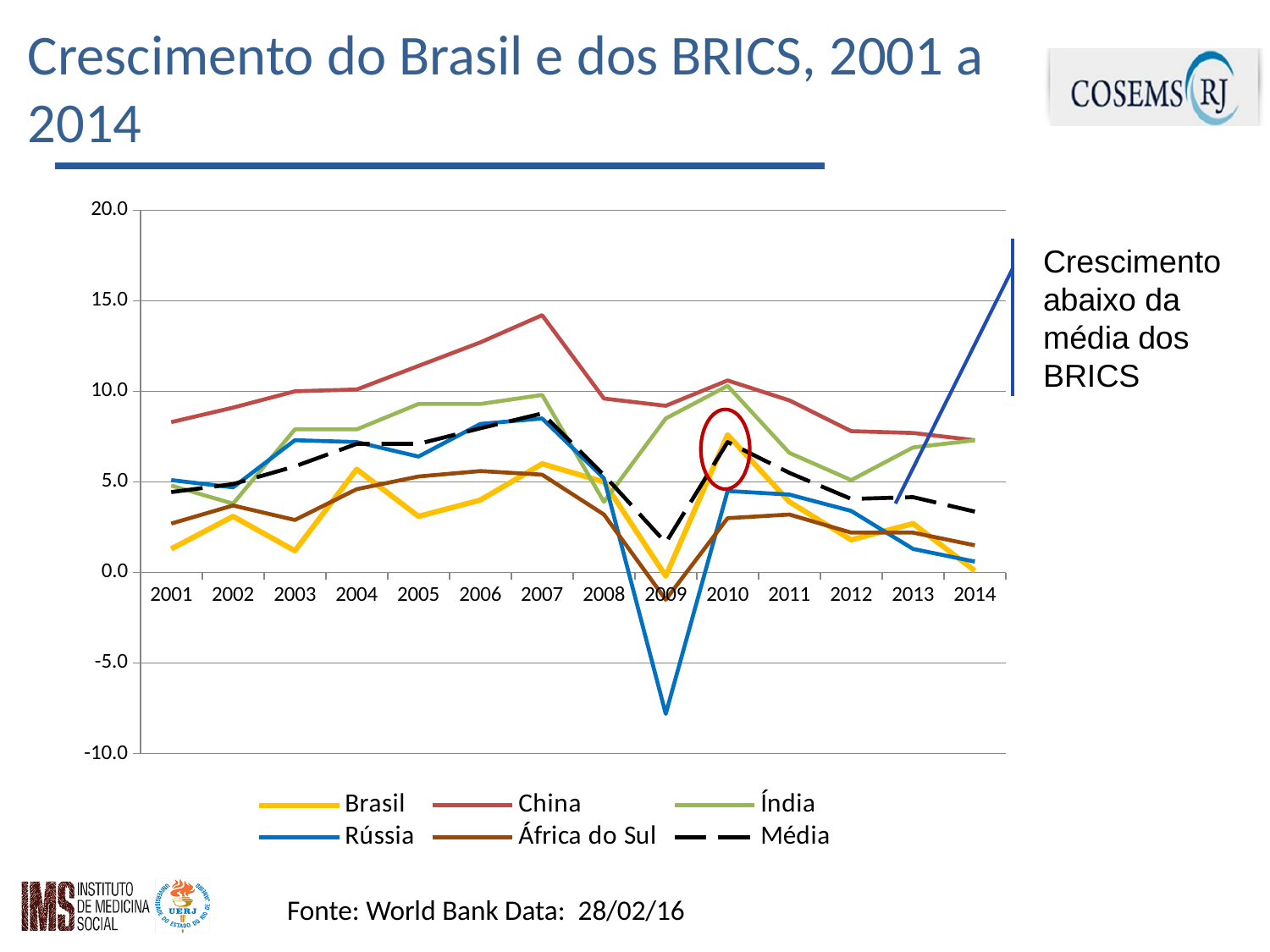
What kind of chart is shown on the slide? line chart Is the value for China in 2007 greater or less than 10.0? greater In 2004, which is larger: the value for China or the value for Brasil? China Does the value for China rise or fall from 2007 to 2014? fall Is the value for Brasil in 2003 greater or less than 5.0? less Which series is drawn with a dashed line? Média Which series has the highest value in 2007? China In which year does China reach its highest value? 2007 How many series does the legend list? 6 Which series has the lowest value in 2009? Rússia Is the value for Rússia in 2009 greater or less than -5.0? less How many years are shown on the x axis? 14